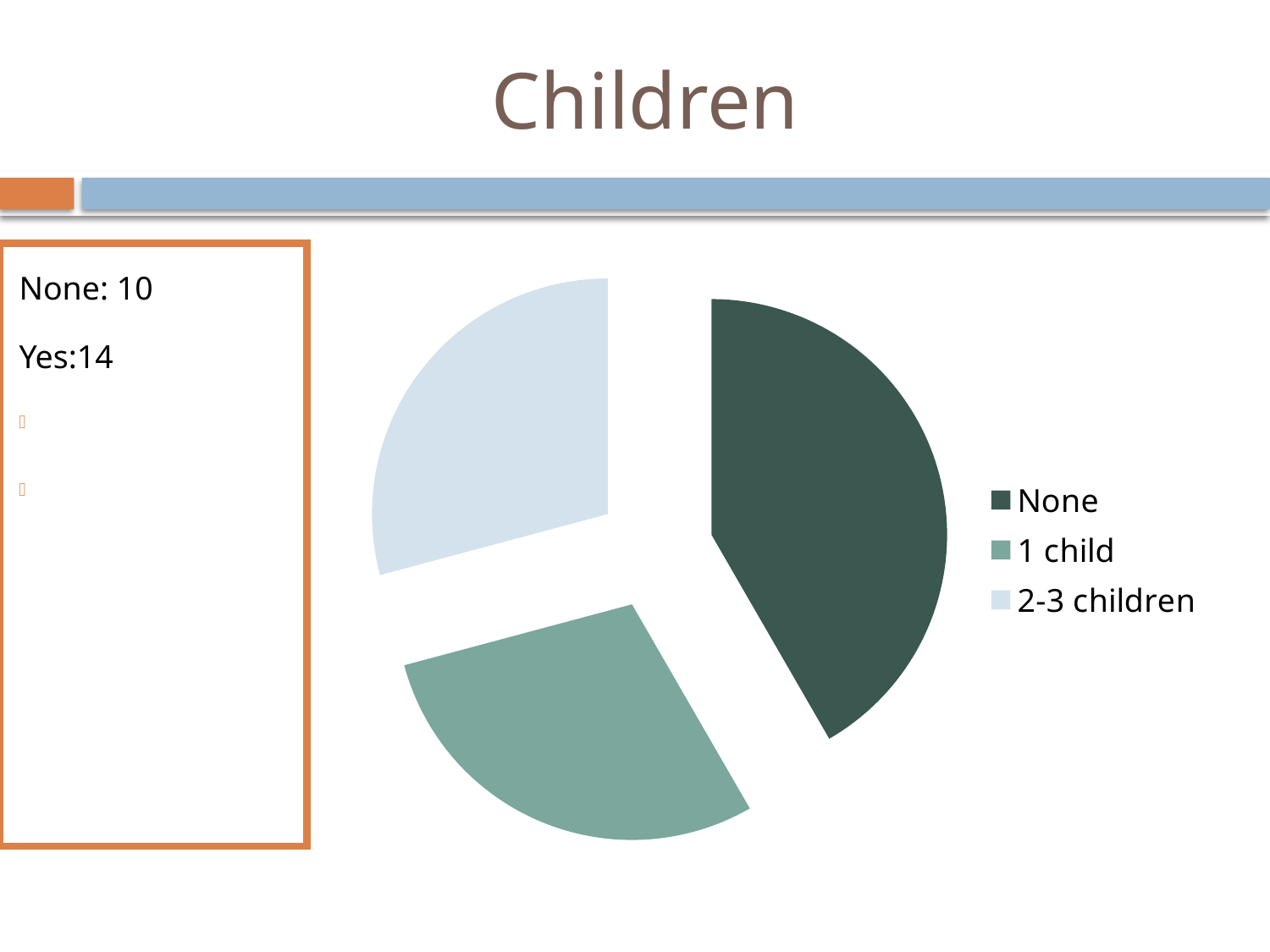
Which slice is larger in the pie chart, None or 2-3 children? None Which category has the largest slice in the pie chart? None Which slice is larger in the pie chart, None or 1 child? None What is the title of the slide containing the pie chart? Children How many slices does the pie chart have? 3 Which legend entry is shown with the darkest green colour in the pie chart? None What kind of chart is shown on the slide? pie chart How many entries does the legend of the pie chart list? 3